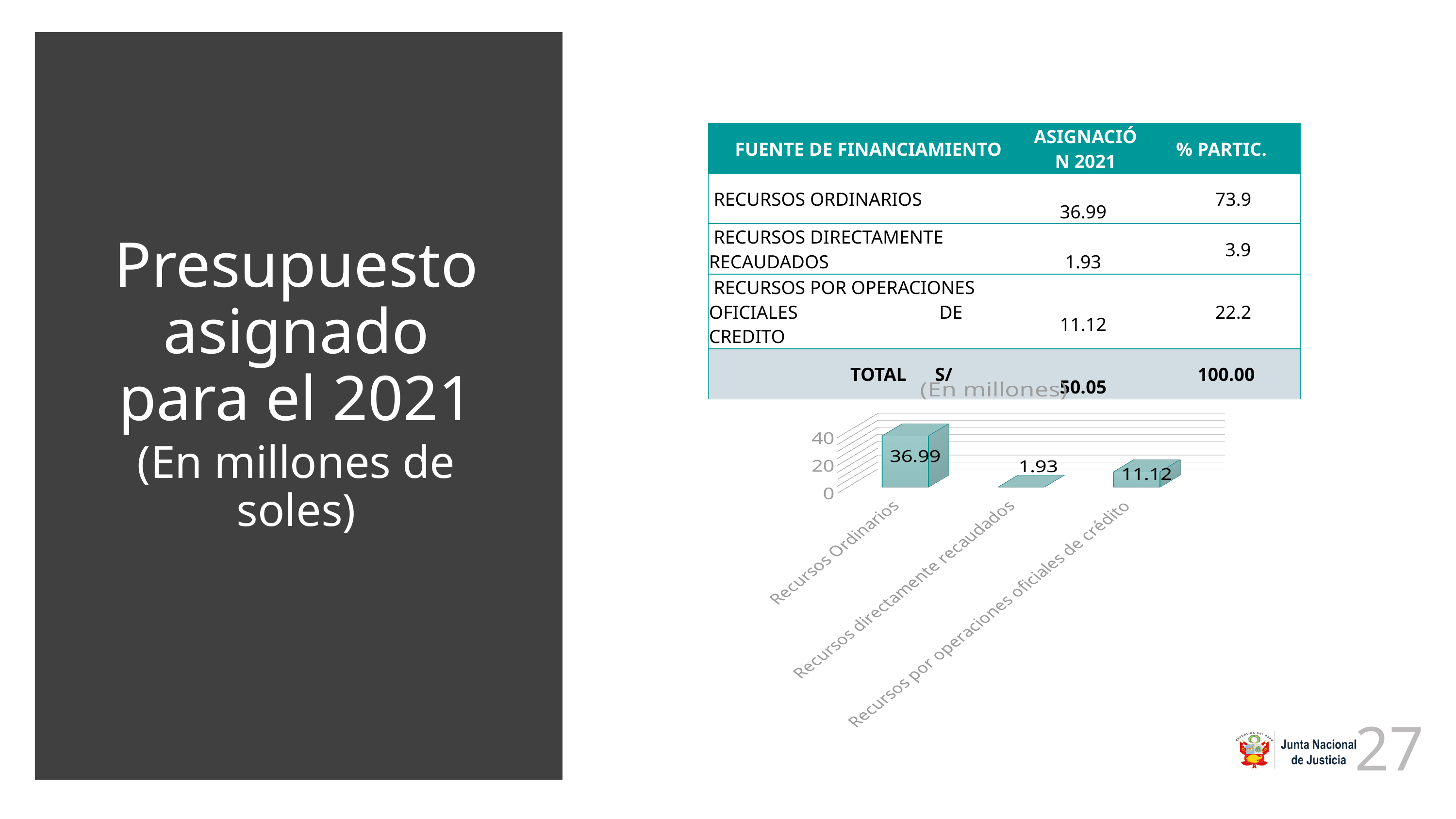
What is the difference between the values for Recursos por operaciones oficiales de crédito and Recursos directamente recaudados? 9.19 Is the value for Recursos por operaciones oficiales de crédito greater or less than 20? less What is the difference between the values for Recursos Ordinarios and Recursos por operaciones oficiales de crédito? 25.87 Which is larger, the value for Recursos Ordinarios or the value for Recursos por operaciones oficiales de crédito? Recursos Ordinarios What is the value for Recursos por operaciones oficiales de crédito in the chart? 11.12 What is the value for Recursos Ordinarios in the chart? 36.99 How many categories are shown in the chart? 3 What kind of chart is shown on the slide? Bar chart Is the value for Recursos Ordinarios greater or less than 20? greater Which category has the highest value in the chart? Recursos Ordinarios What is the value for Recursos directamente recaudados in the chart? 1.93 Which category has the lowest value in the chart? Recursos directamente recaudados